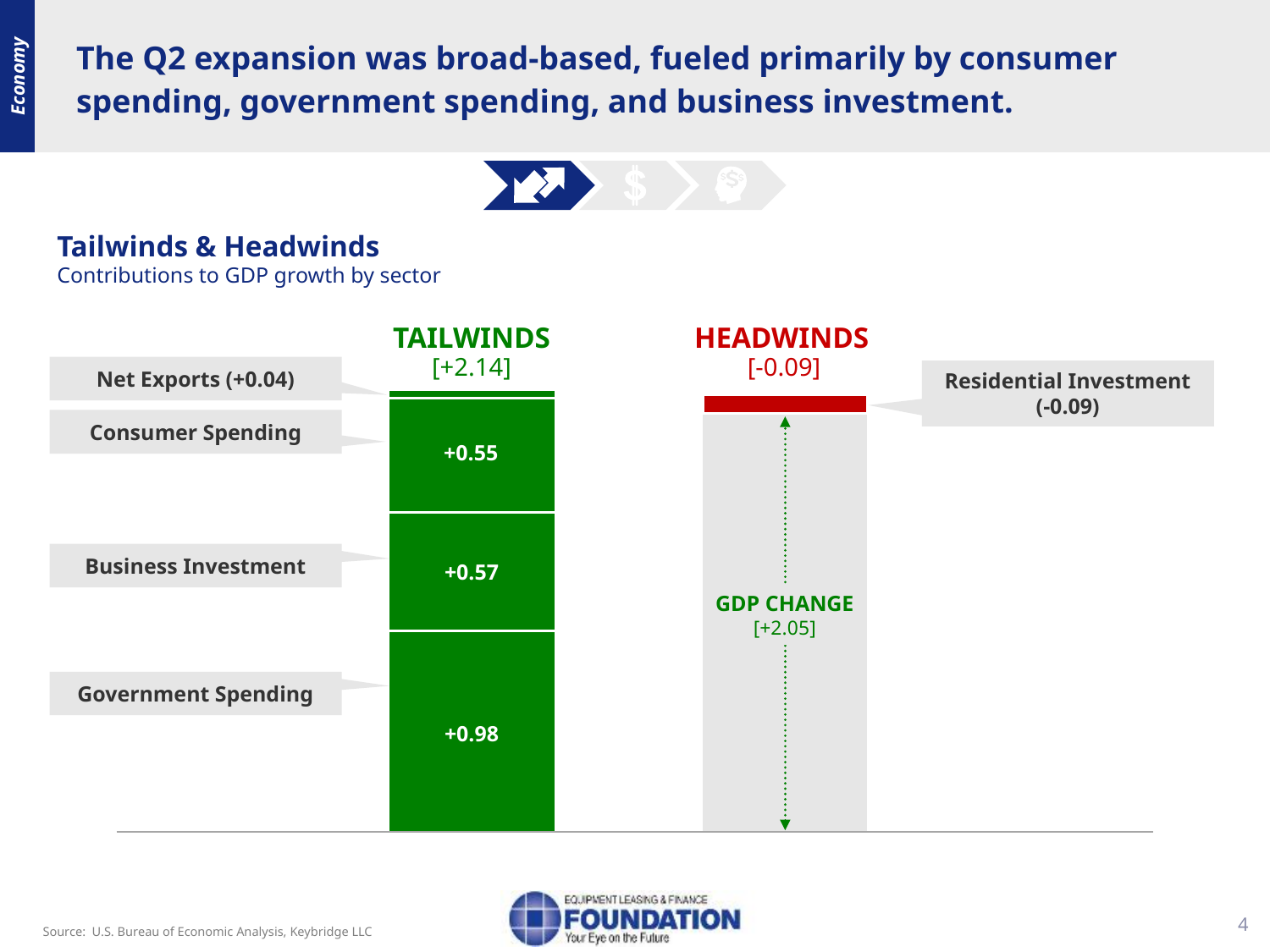
What is the overall GDP change shown on the chart? +2.05 What is the contribution of Consumer Spending to GDP growth? +0.55 What is the total of the Tailwinds bar? +2.14 What is the contribution of Residential Investment to GDP growth? -0.09 What is the contribution of Net Exports to GDP growth? +0.04 Which sector contributes the most to GDP growth among the tailwinds? Government Spending What is the contribution of Government Spending to GDP growth in the Tailwinds & Headwinds chart? +0.98 What is the total of the Headwinds bar? -0.09 Which contributes more to GDP growth, Business Investment or Consumer Spending? Business Investment What is the difference between the Government Spending and Consumer Spending contributions? 0.43 Which tailwind sector has the smallest contribution to GDP growth? Net Exports What is the contribution of Business Investment to GDP growth? +0.57